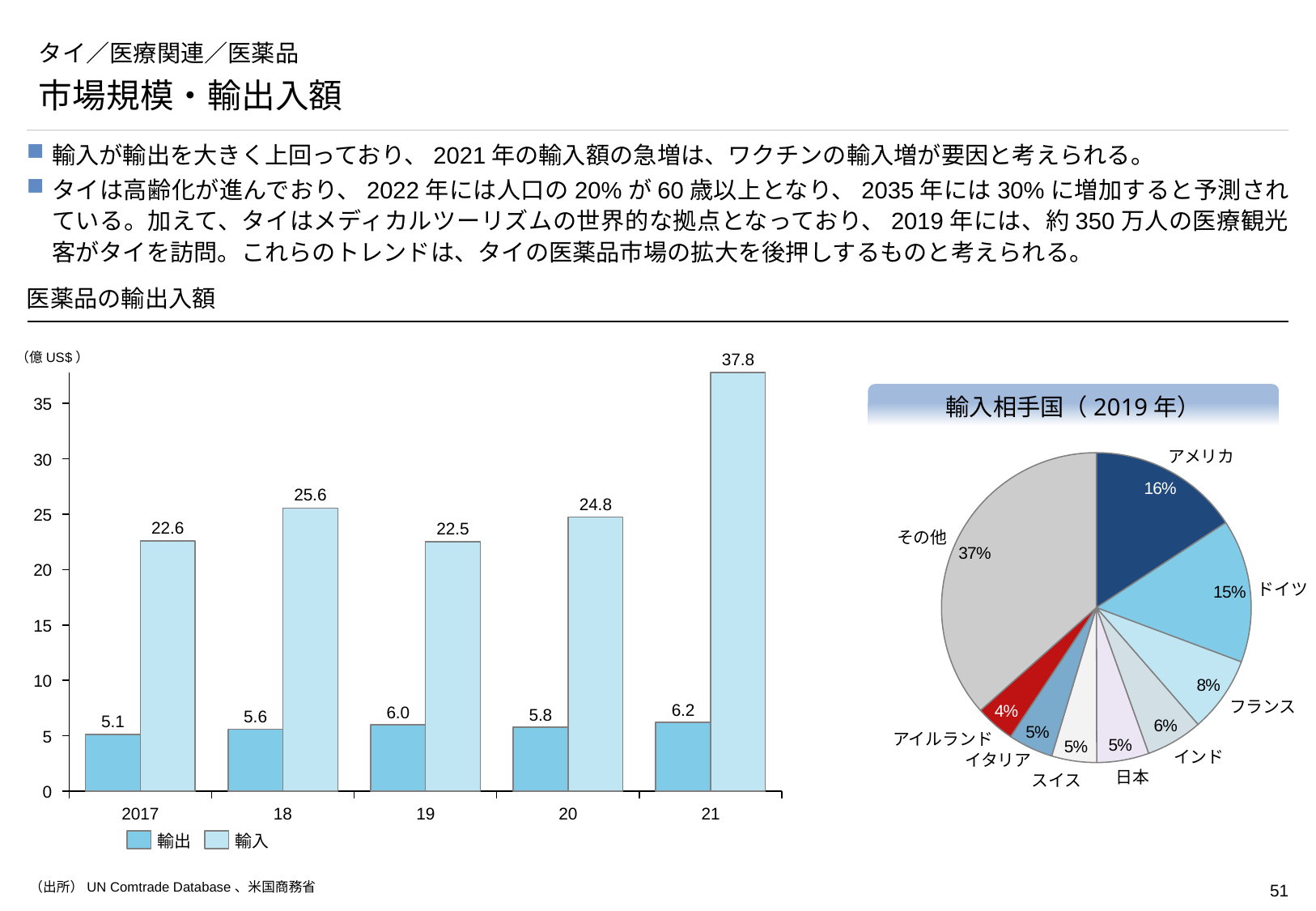
In the pie chart 輸入相手国（2019年）, which slice is the smallest? アイルランド In the bar chart 医薬品の輸出入額, how many series does the legend list? 2 In the pie chart 輸入相手国（2019年）, how many slices are there? 9 In the pie chart 輸入相手国（2019年）, what share does ドイツ have? 15% In the bar chart 医薬品の輸出入額, which year has the lowest 輸出 value? 2017 In the pie chart 輸入相手国（2019年）, which slice is the largest? その他 In the bar chart 医薬品の輸出入額, what is the 輸入 value for 21? 37.8 In the bar chart 医薬品の輸出入額, which year has the highest 輸入 value? 21 In the bar chart 医薬品の輸出入額, what is the difference between the 輸入 value for 21 and the 輸入 value for 20? 13.0 In the bar chart 医薬品の輸出入額, which is larger: the 輸入 value for 18 or the 輸入 value for 19? 18 In the bar chart 医薬品の輸出入額, what is the 輸出 value for 2017? 5.1 What kind of chart is 医薬品の輸出入額? bar chart